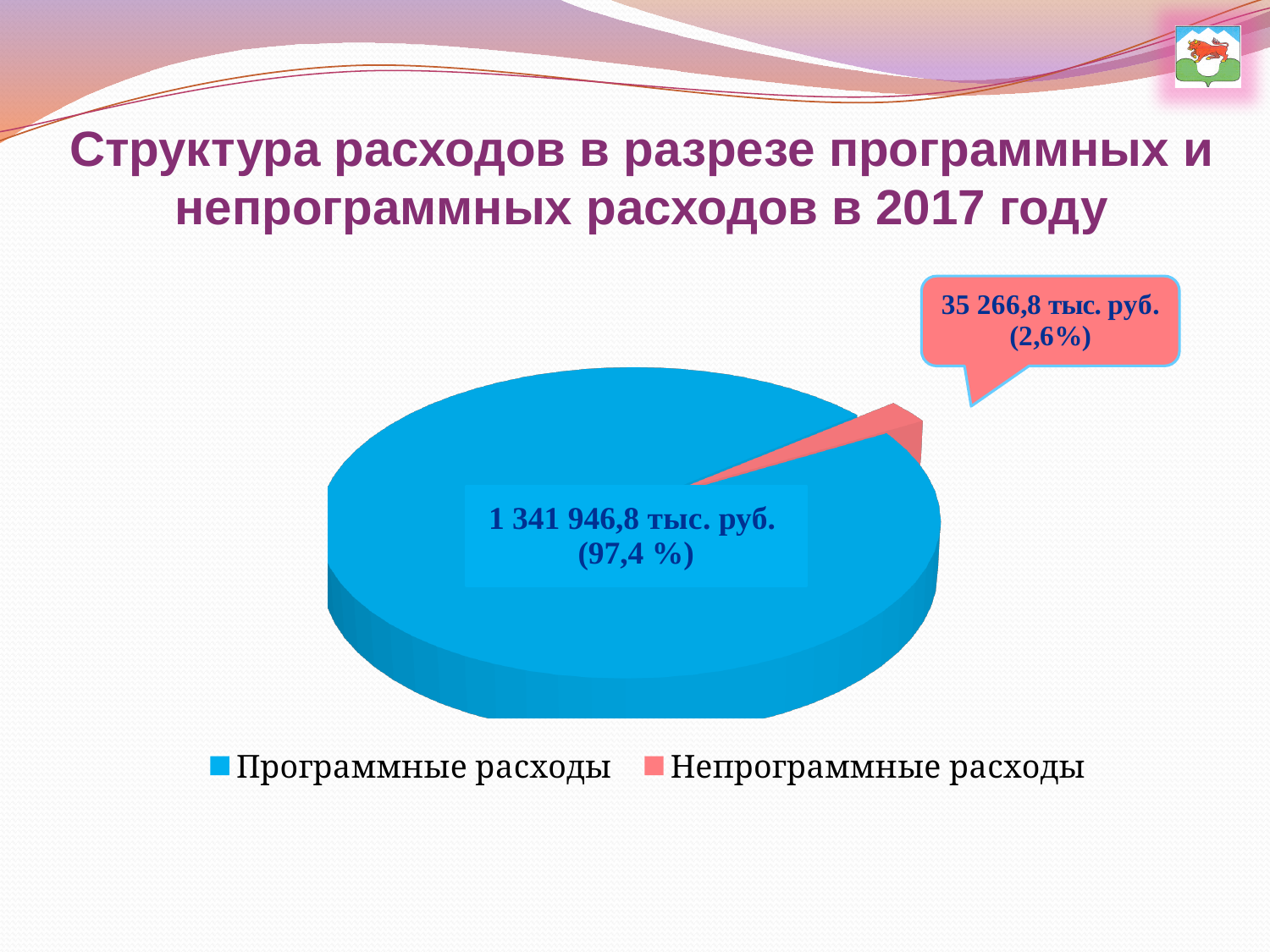
Which category has the largest slice of the pie? Программные расходы What colour is the slice for Непрограммные расходы? Red (pink) What kind of chart is shown on the slide? Pie chart Which category has the smallest slice of the pie? Непрограммные расходы What share of the pie does Непрограммные расходы represent? 2,6% What is the title of the slide? Структура расходов в разрезе программных и непрограммных расходов в 2017 году What share of the pie does Программные расходы represent? 97,4 % What is the value for Непрограммные расходы? 35 266,8 тыс. руб. How many entries does the legend list? 2 What is the value for Программные расходы? 1 341 946,8 тыс. руб. How many categories does the pie chart show? 2 Which is larger, Программные расходы or Непрограммные расходы? Программные расходы